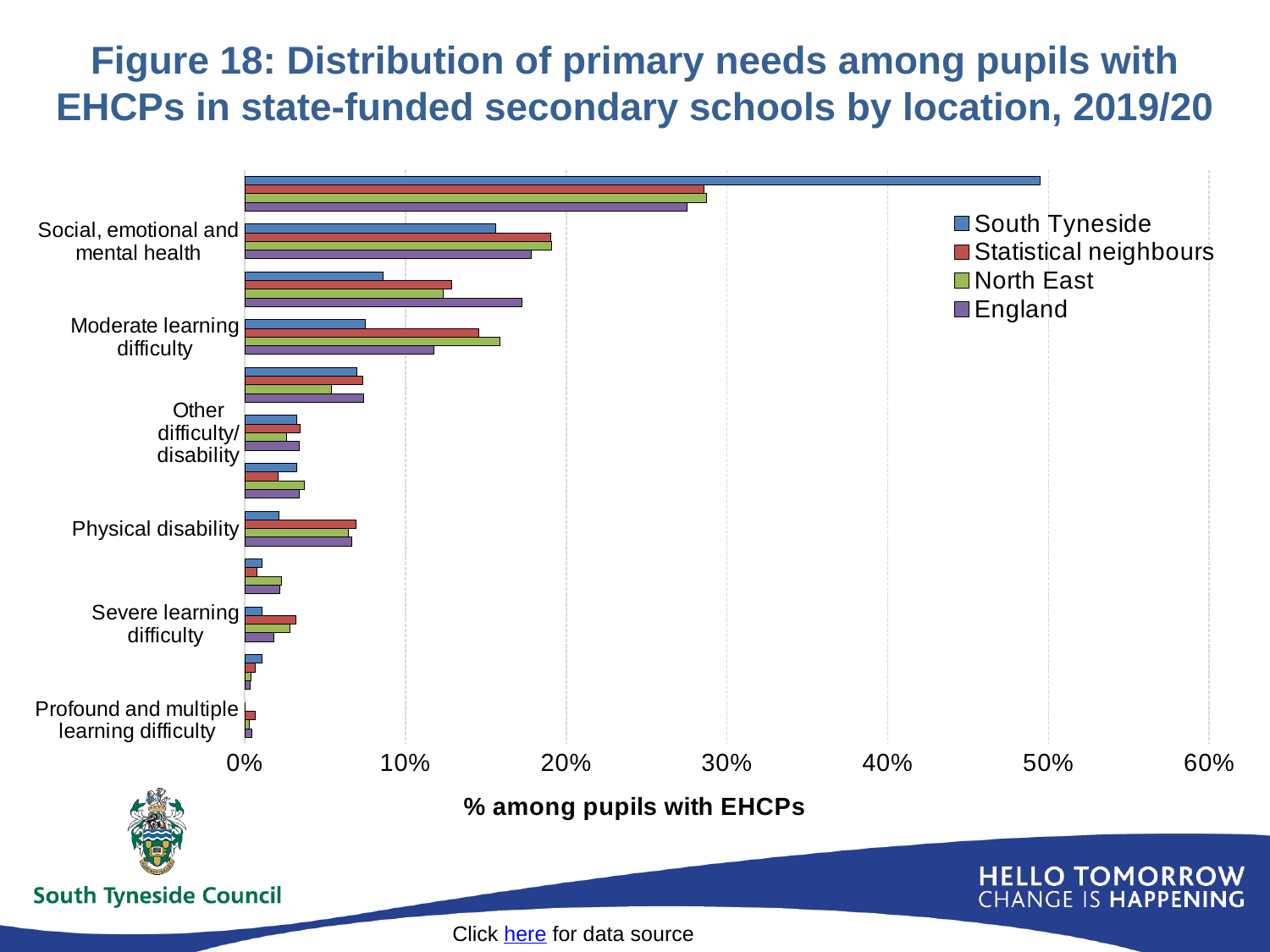
Is the South Tyneside value for Social, emotional and mental health greater or less than 10%? greater Is the South Tyneside value for Social, emotional and mental health greater or less than 20%? less For Physical disability, which series has the lowest value? South Tyneside How many series does the legend list? 4 Is the North East value for Moderate learning difficulty greater or less than 10%? greater Which series are listed in the legend? South Tyneside, Statistical neighbours, North East, England For Physical disability, which is larger: the Statistical neighbours value or the South Tyneside value? Statistical neighbours What kind of chart is shown on the slide? bar chart What is the title of the x axis? % among pupils with EHCPs For Moderate learning difficulty, which is larger: the North East value or the South Tyneside value? North East